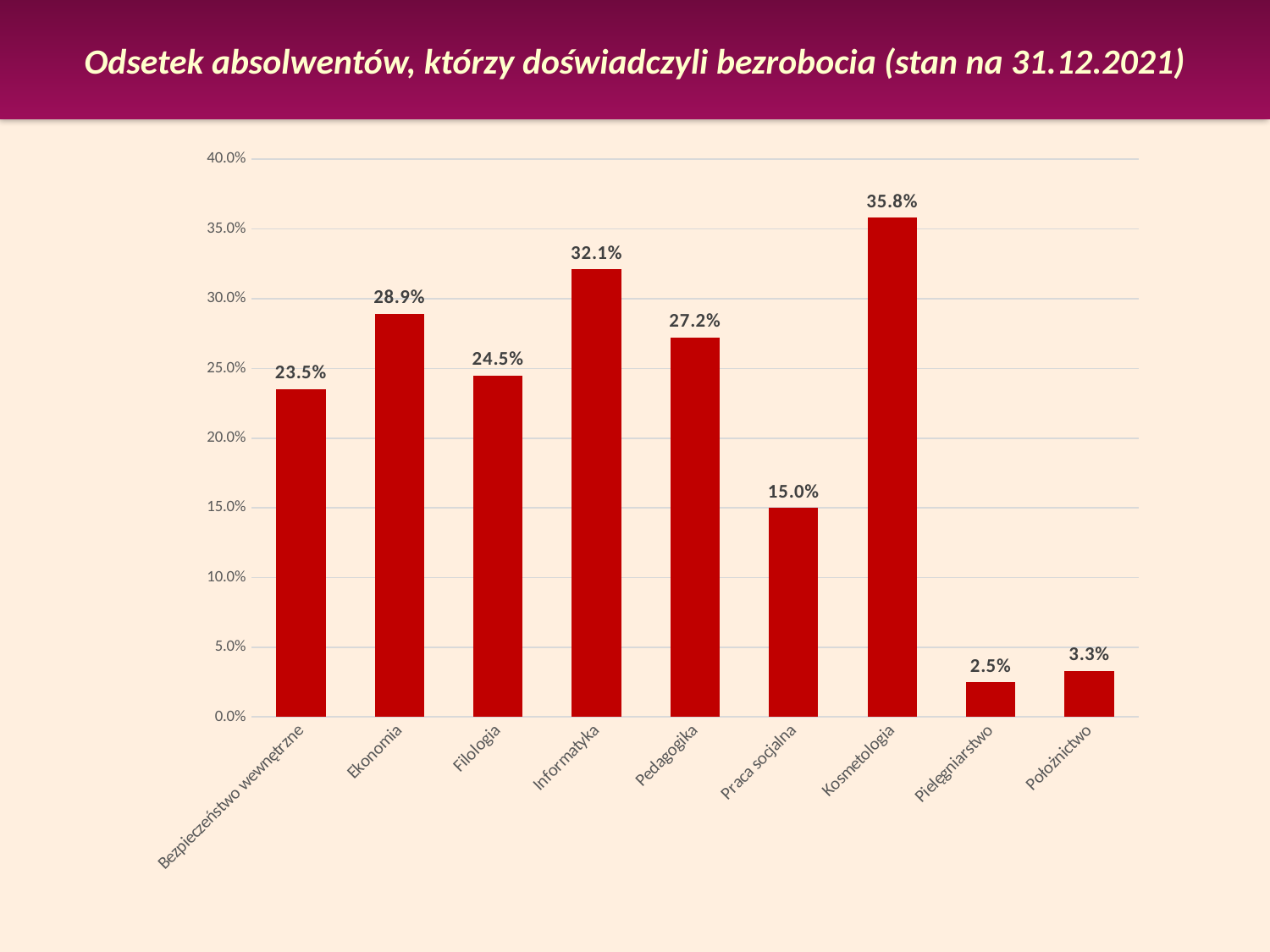
What is the title of the chart? Odsetek absolwentów, którzy doświadczyli bezrobocia (stan na 31.12.2021) Which is larger, the value for Pedagogika or the value for Filologia? Pedagogika What is the value for Pielęgniarstwo? 2.5% What kind of chart is shown on the slide? bar chart How many categories are shown on the x axis? 9 What is the difference between the values for Kosmetologia and Ekonomia? 6.9% What is the value for Informatyka? 32.1% What is the difference between the values for Położnictwo and Pielęgniarstwo? 0.8% Which category has the lowest value? Pielęgniarstwo Is the value for Bezpieczeństwo wewnętrzne greater or less than 25.0%? less Which category has the highest value? Kosmetologia What is the value for Praca socjalna? 15.0%